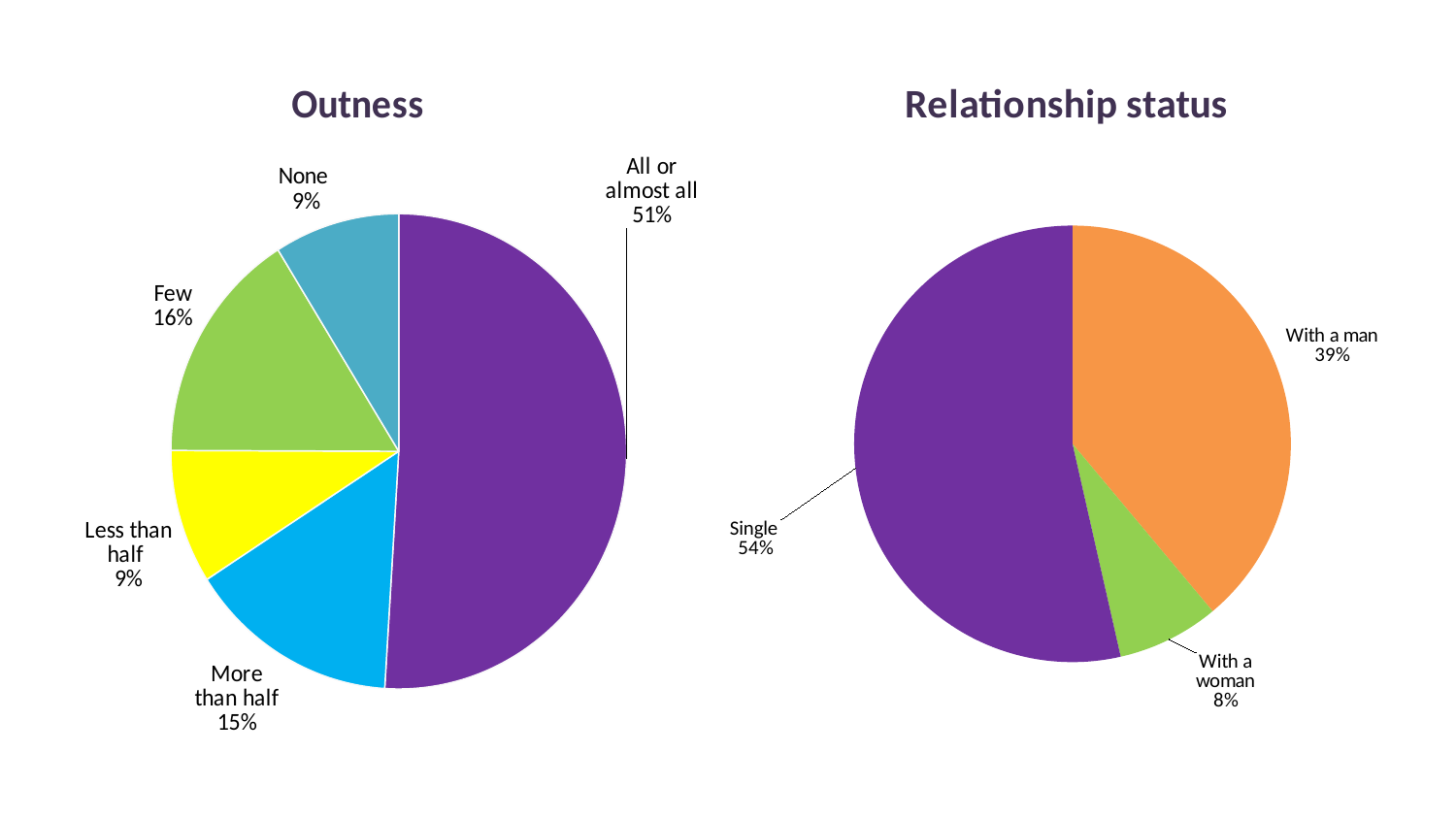
In the Outness chart, how many slices does the pie have? 5 In the Outness chart, what is the value for 'Few'? 16% In the Relationship status chart, how many categories are shown? 3 In the Outness chart, which is larger, 'More than half' or 'Less than half'? More than half What type of chart is the Relationship status chart? Pie chart In the Relationship status chart, what is the value for 'With a man'? 39% In the Outness chart, what is the difference between 'Few' and 'More than half'? 1% In the Outness chart, what share of the pie is 'All or almost all'? 51% In the Relationship status chart, what colour is the 'Single' slice? Purple In the Relationship status chart, what is the difference between 'Single' and 'With a man'? 15% In the Relationship status chart, which category has the smallest slice? With a woman In the Outness chart, which category has the largest slice? All or almost all